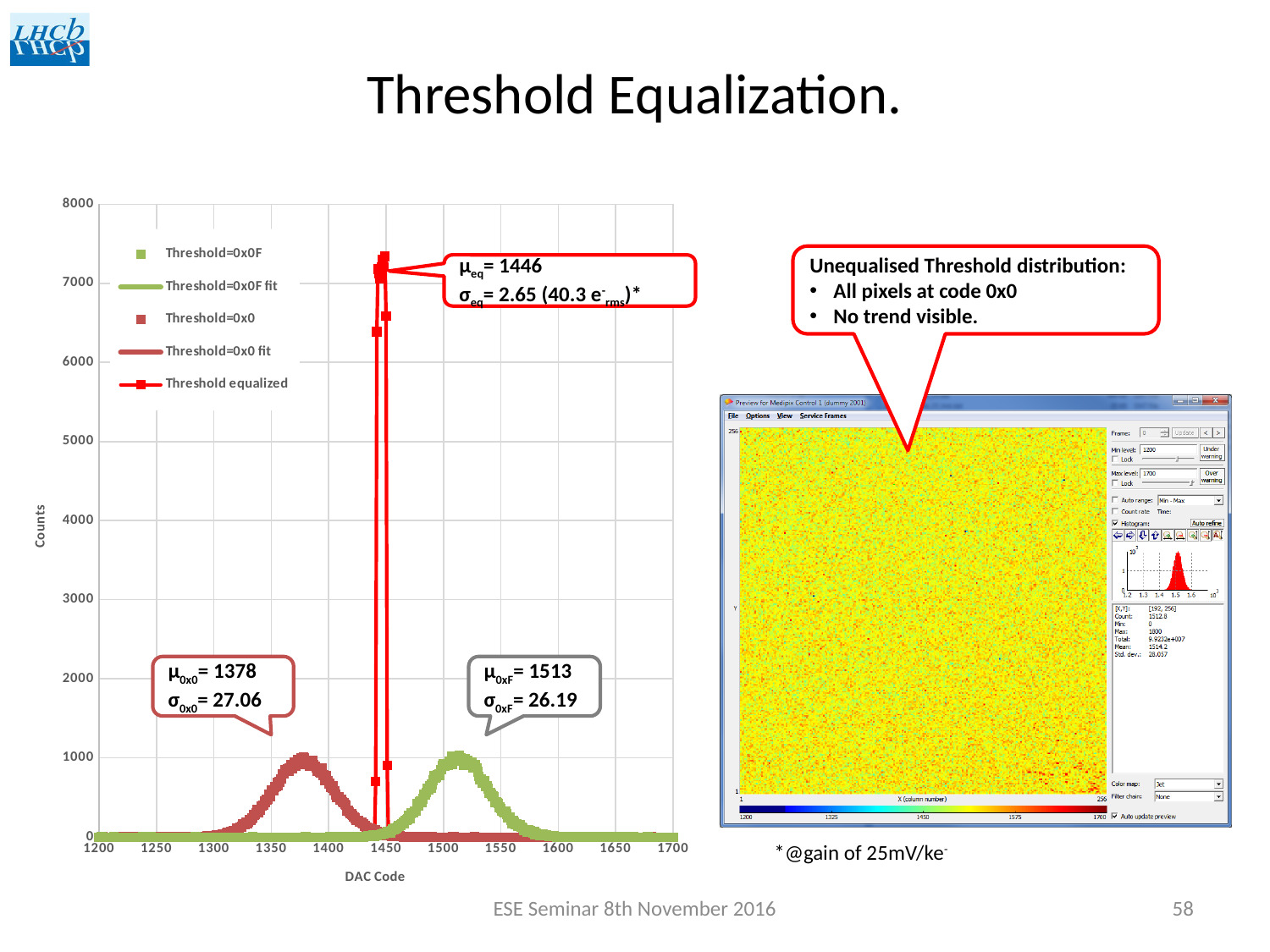
What is the σ of the Threshold=0xF distribution shown in the callout? 26.19 What is the mean (μ) of the Threshold=0x0 distribution shown in the callout? 1378 Is the peak count of the Threshold equalized series greater or less than 7000? greater Which of the three distributions has the smallest σ? Threshold equalized Which of the three distributions has the largest mean (μ)? Threshold=0xF Is the peak count of the Threshold=0x0 series greater or less than 2000? less What is the title of the x axis of the chart? DAC Code What is the difference between the means of the Threshold=0xF and Threshold=0x0 distributions? 135 How many series does the legend of the chart list? 5 What is the title of the y axis of the chart? Counts What is the σ of the equalized threshold distribution shown in the callout? 2.65 What is the mean (μ) of the equalized threshold distribution shown in the callout? 1446